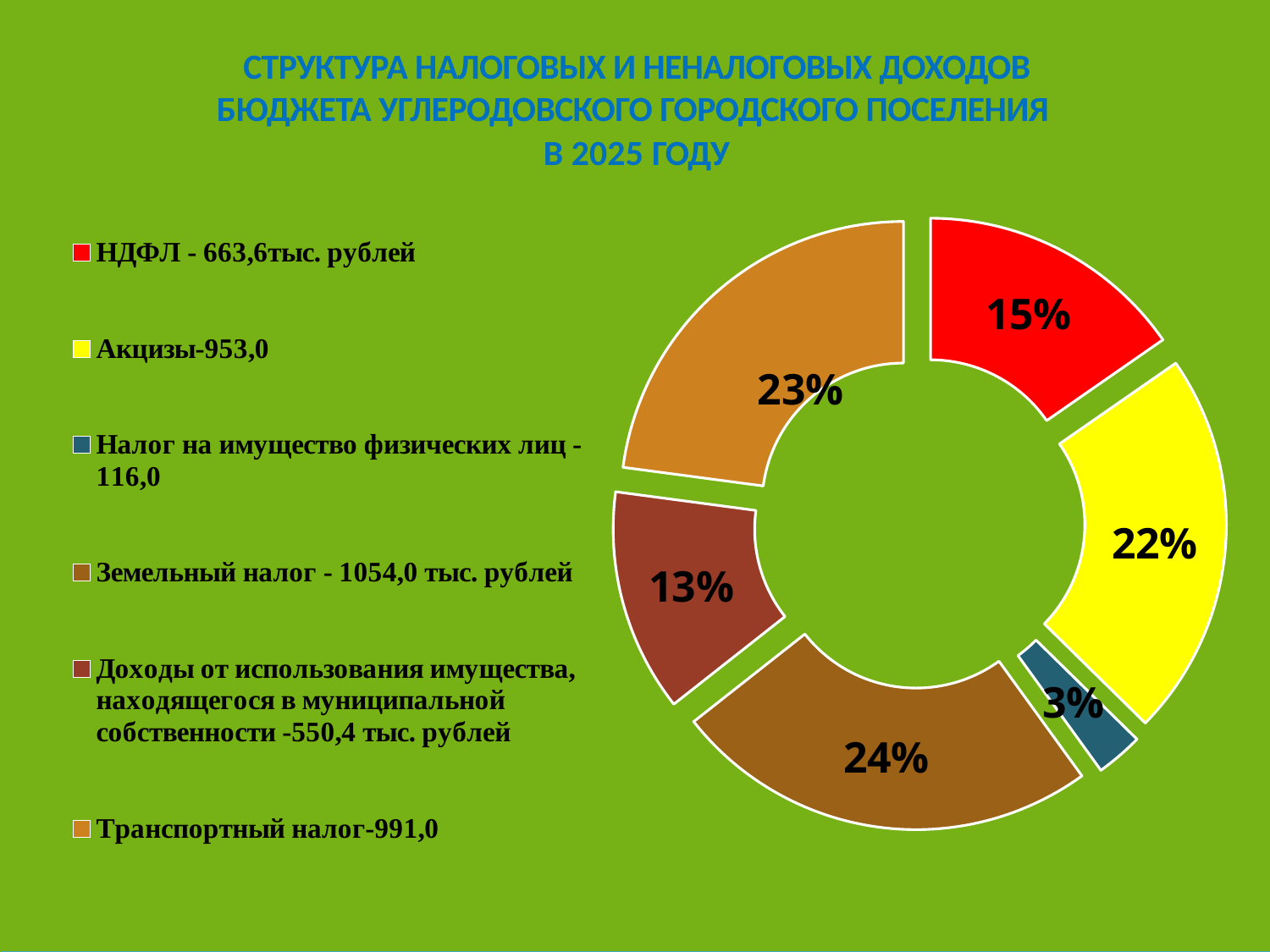
How many categories are shown in the chart? 6 What share of the pie does Акцизы represent? 22% What kind of chart is shown on the slide? Pie (doughnut) chart Which category has the largest share of the pie? Земельный налог What share of the pie does НДФЛ represent? 15% What amount is listed in the legend for Земельный налог? 1054,0 тыс. рублей What share of the pie does Транспортный налог represent? 23% What is the difference in percentage points between the share of Земельный налог and the share of Доходы от использования имущества, находящегося в муниципальной собственности? 11 Which has the larger share: Акцизы or НДФЛ? Акцизы Which category has the smallest share of the pie? Налог на имущество физических лиц